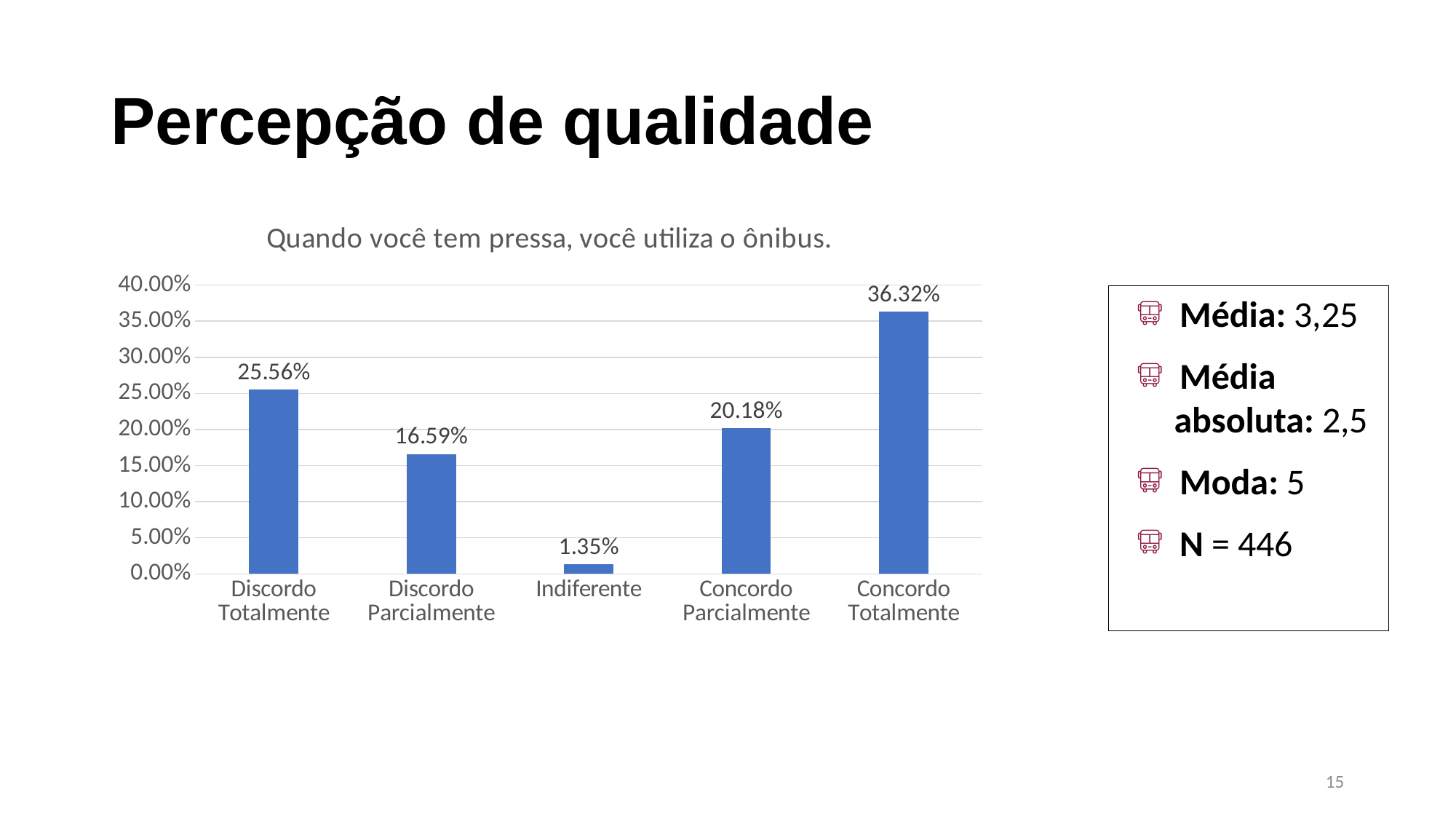
What kind of chart is shown on the slide? bar chart Which is larger, the value for Discordo Totalmente or the value for Concordo Parcialmente? Discordo Totalmente Which category has the highest value? Concordo Totalmente How many categories are shown on the x axis? 5 Which category has the lowest value? Indiferente Is the value for Concordo Parcialmente greater or less than 25.00%? less What is the value for Discordo Parcialmente? 16.59% What is the value for Indiferente? 1.35% What is the difference between the values for Discordo Totalmente and Discordo Parcialmente? 8.97% What is the value for Concordo Totalmente? 36.32% What is the title of the chart? Quando você tem pressa, você utiliza o ônibus. What is the difference between the values for Concordo Totalmente and Discordo Totalmente? 10.76%